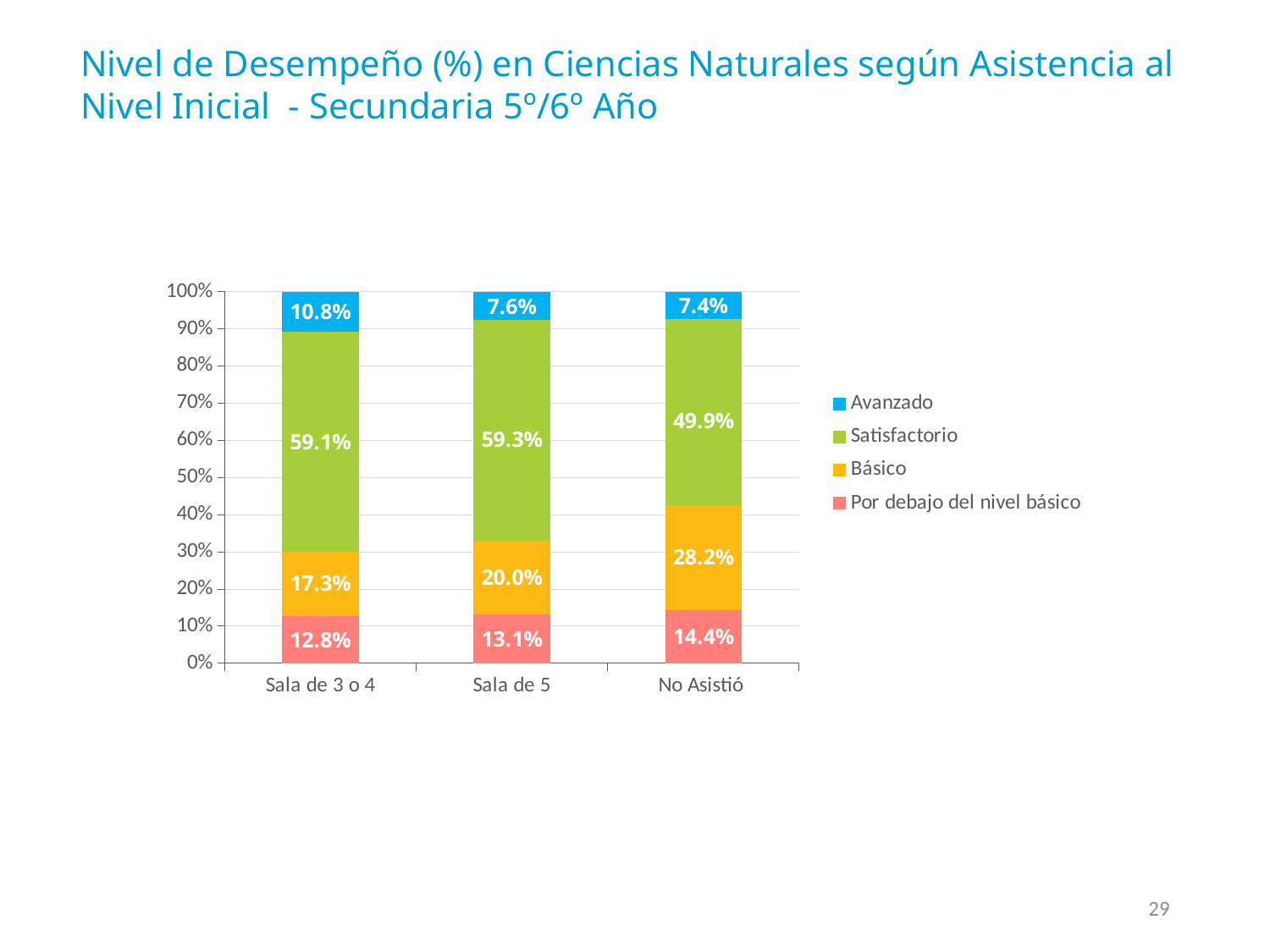
What is the Por debajo del nivel básico value for No Asistió? 14.4% Which category has the highest Básico value? No Asistió Which is larger, the Satisfactorio value for Sala de 5 or for No Asistió? Sala de 5 What is the Satisfactorio value for No Asistió? 49.9% What is the Básico value for Sala de 5? 20.0% What is the difference between the Básico values for No Asistió and Sala de 3 o 4? 10.9% Which category has the lowest Avanzado value? No Asistió What kind of chart is shown on the slide? Stacked bar chart Which colour represents the Avanzado series? Blue How many series does the legend list? 4 How many categories are shown on the x axis? 3 What is the Avanzado value for Sala de 3 o 4? 10.8%